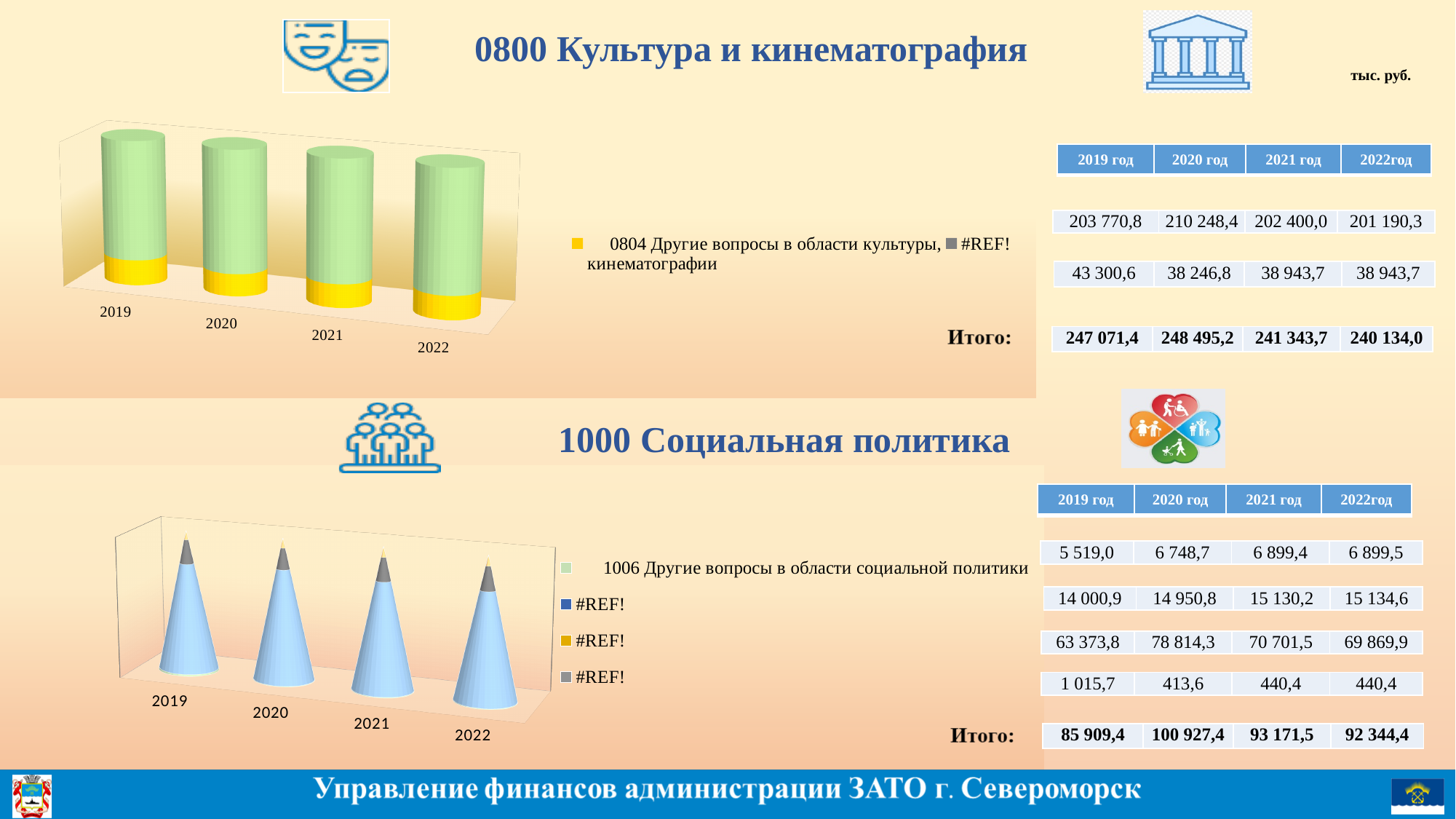
In the bottom chart, 1000 Социальная политика, which year is the last category on the x axis? 2022 How many categories are shown on the x axis of the bottom chart, 1000 Социальная политика? 4 In the top chart, 0800 Культура и кинематография, which year is the first category on the x axis? 2019 How many series does the legend of the top chart, 0800 Культура и кинематография, list? 2 How many series does the legend of the bottom chart, 1000 Социальная политика, list? 4 In the top chart, 0800 Культура и кинематография, is the yellow segment for 2019 larger or smaller than the yellow segment for 2022? larger How many years are shown on the x axis of the top chart, 0800 Культура и кинематография? 4 What kind of chart is the top chart, 0800 Культура и кинематография? bar chart In the bottom chart, 1000 Социальная политика, what is the first legend entry? 1006 Другие вопросы в области социальной политики In the top chart, 0800 Культура и кинематография, what is the first legend entry? 0804 Другие вопросы в области культуры, кинематографии What kind of chart is the bottom chart, 1000 Социальная политика? bar chart